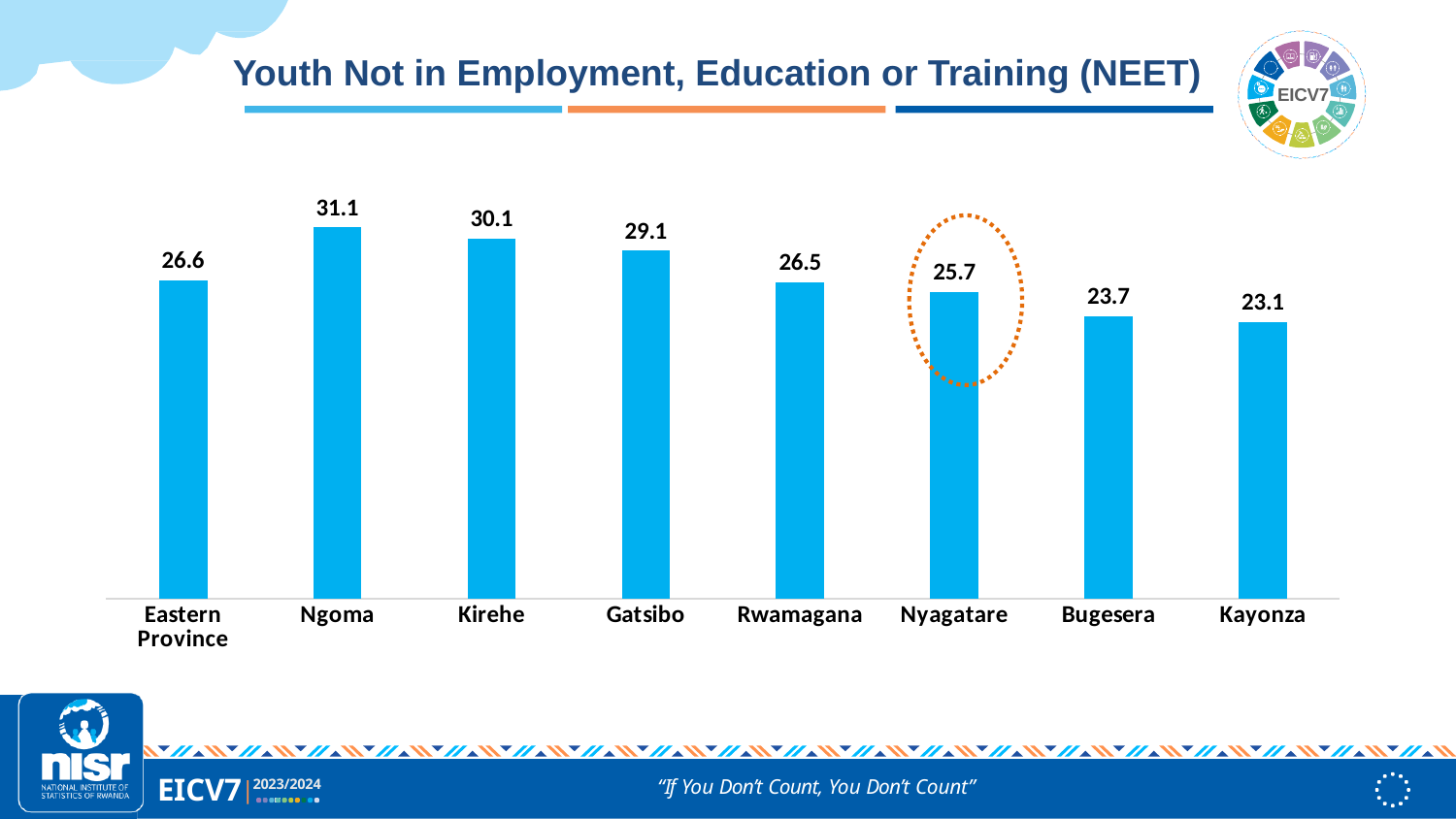
What is the NEET value for Ngoma? 31.1 Which category is highlighted with a dotted orange circle? Nyagatare What is the difference between the NEET values for Kirehe and Gatsibo? 1.0 Which category has the lowest NEET value? Kayonza What is the difference between the NEET values for Ngoma and Kayonza? 8.0 What is the NEET value for Eastern Province? 26.6 What is the title of the slide? Youth Not in Employment, Education or Training (NEET) What is the NEET value for Nyagatare? 25.7 Which has a higher NEET value, Rwamagana or Bugesera? Rwamagana What kind of chart is shown on the slide? Bar chart Which category has the highest NEET value? Ngoma How many categories are shown on the x axis? 8